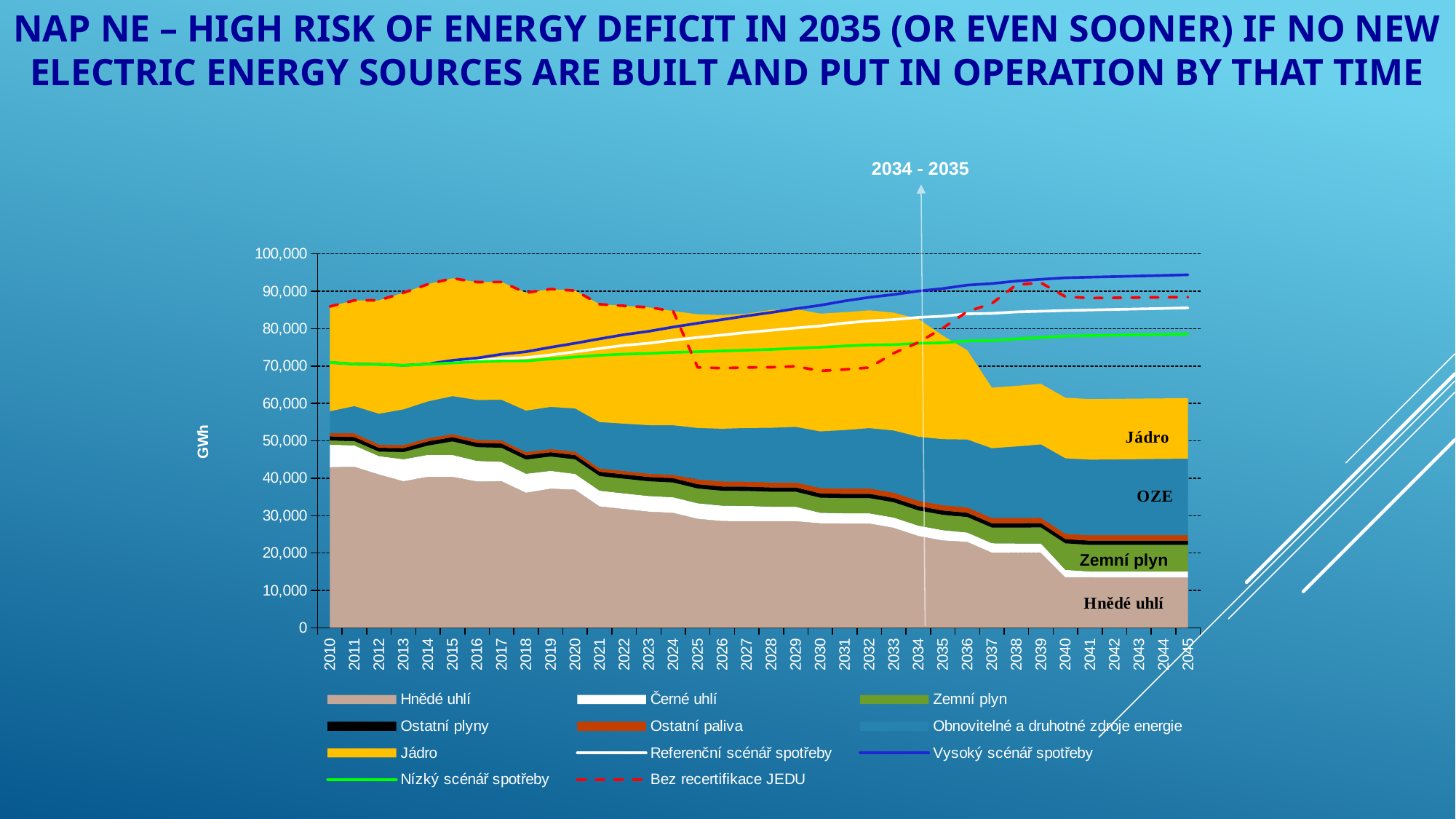
Is the value for Nízký scénář spotřeby in 2045 greater or less than 80,000? less How many years are shown along the x axis? 36 Is the value for Hnědé uhlí in 2045 greater or less than 20,000? less Is the value for Bez recertifikace JEDU in 2030 greater or less than 80,000? less In 2045, which is larger: Vysoký scénář spotřeby or Nízký scénář spotřeby? Vysoký scénář spotřeby Does the Hnědé uhlí area rise or fall from 2010 to 2045? fall What period is marked by the vertical arrow annotation above the chart? 2034 - 2035 What unit is shown on the y axis label? GWh What kind of chart is shown on the slide? Stacked area chart with line series How many series does the legend list? 11